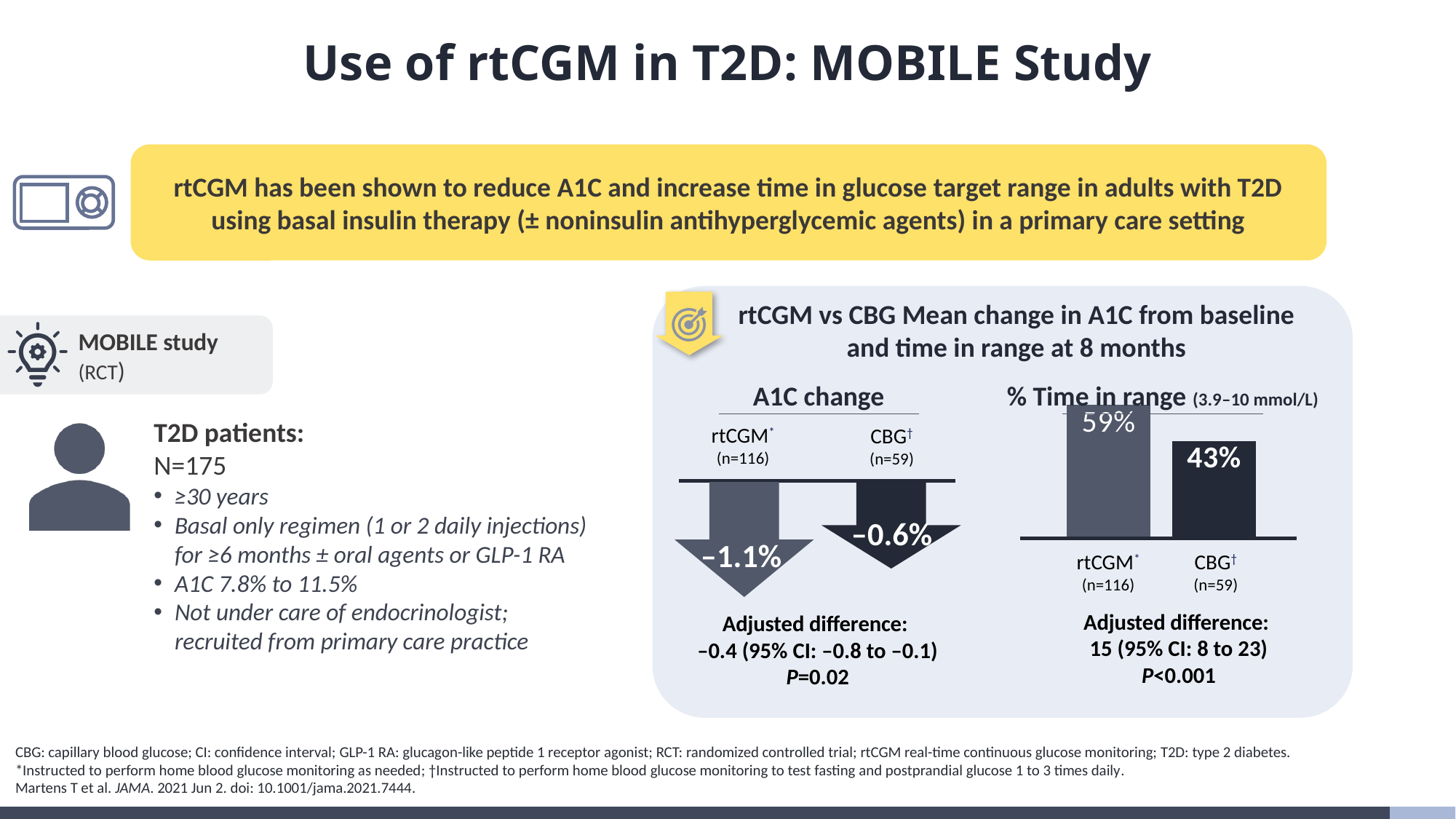
What kind of chart is the % Time in range chart? bar chart How many groups are shown in the % Time in range chart? 2 In the % Time in range chart, what is the value for rtCGM? 59% In the % Time in range chart, which group has the higher value, rtCGM or CBG? rtCGM In the % Time in range chart, what is the value for CBG? 43% What is the adjusted difference reported below the % Time in range chart? 15 (95% CI: 8 to 23) In the % Time in range chart, what is the sample size (n) for the CBG group? 59 In the A1C change chart, what is the mean change in A1C for rtCGM? –1.1% In the A1C change chart, what is the sample size (n) for the rtCGM group? 116 What glucose range is used to define time in range in the % Time in range chart? 3.9–10 mmol/L In the A1C change chart, what is the mean change in A1C for CBG? –0.6% In the A1C change chart, which group shows the larger reduction in A1C? rtCGM